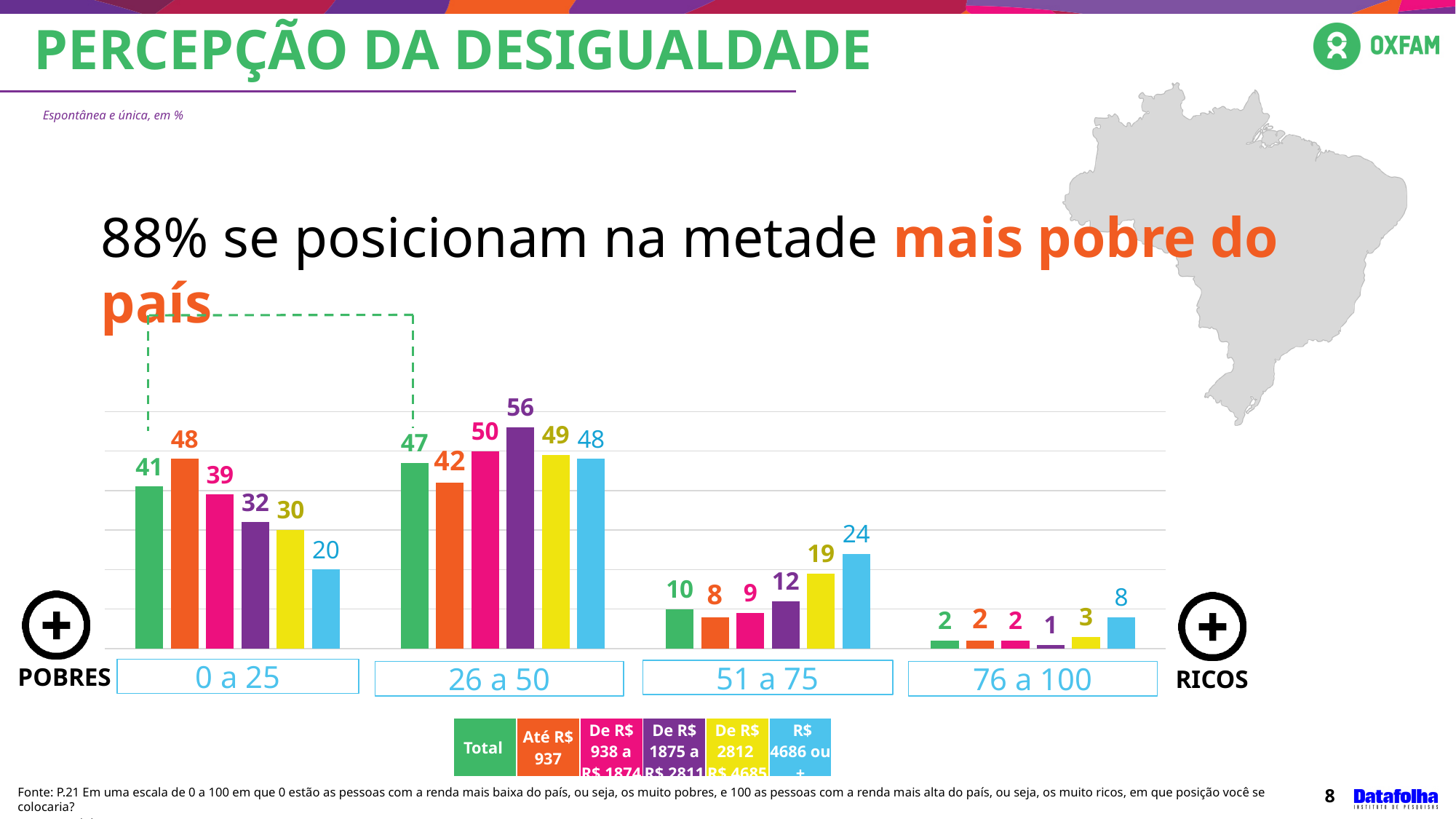
What kind of chart is shown on the slide? Bar chart What is the value for the R$ 4686 ou + series in the 76 a 100 category? 8 How many series does the legend list? 6 How many categories are shown on the x axis of the chart? 4 What is the value for the Até R$ 937 series in the 26 a 50 category? 42 What is the value for the Total series in the 0 a 25 category? 41 Which series has the lowest value in the 0 a 25 category? R$ 4686 ou + What is the value for the R$ 4686 ou + series in the 51 a 75 category? 24 In the 0 a 25 category, which is larger: the Total value or the Até R$ 937 value? Até R$ 937 Which category has the highest value for the Total series? 26 a 50 What is the difference between the Total values for the 0 a 25 and 26 a 50 categories? 6 Does the Total series rise or fall from the 26 a 50 category to the 76 a 100 category? Fall